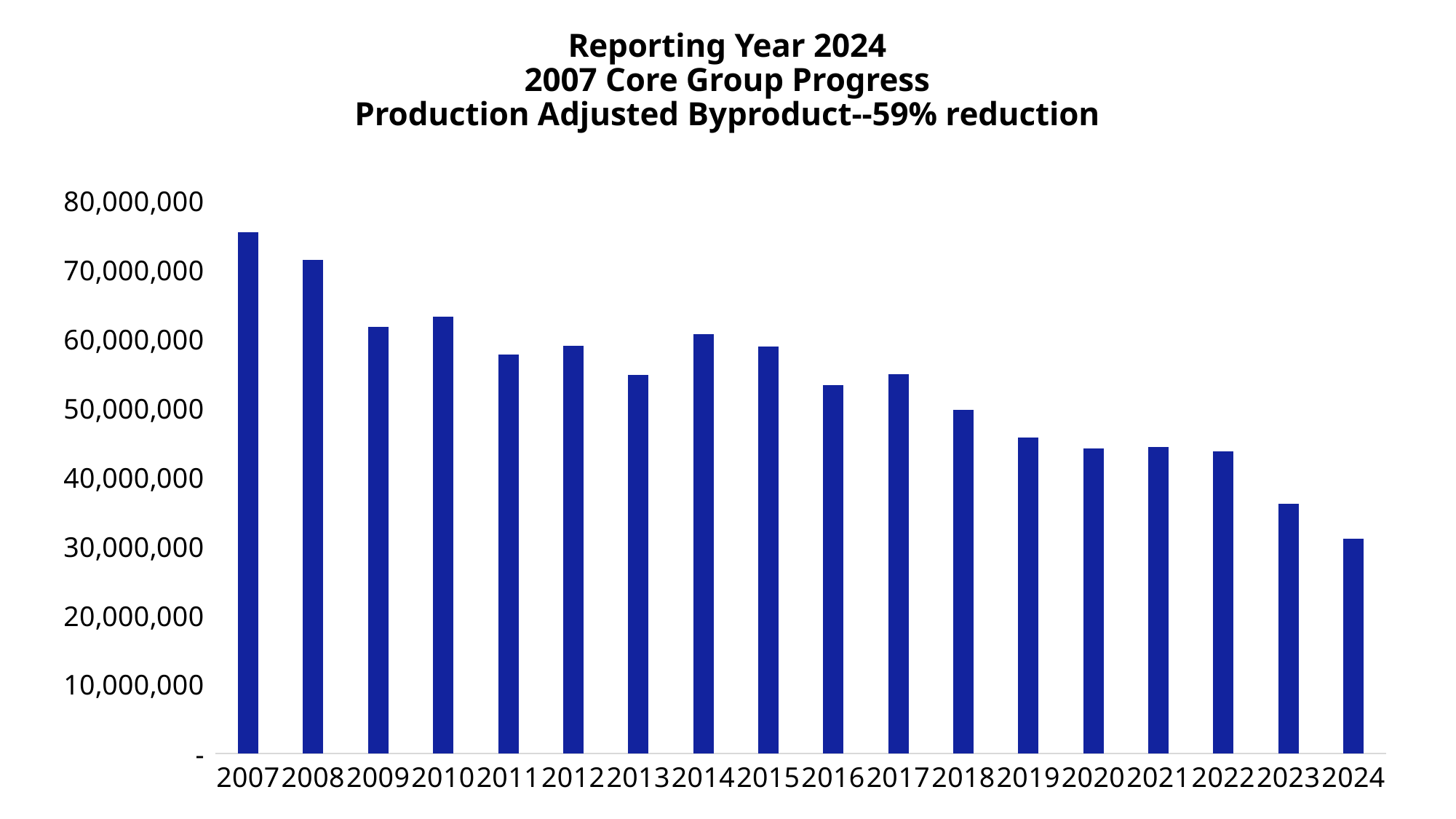
Which year has the lowest bar? 2024 Is the value for 2013 greater or less than 60,000,000? less Is the value for 2019 greater or less than 40,000,000? greater What percentage reduction is stated in the chart title? 59% Which is larger, the value for 2014 or the value for 2013? 2014 What kind of chart is shown on the slide? bar chart Do the values generally rise or fall from 2007 to 2024? fall Which year has the highest bar? 2007 Is the value for 2007 greater or less than 70,000,000? greater How many years are plotted on the x axis? 18